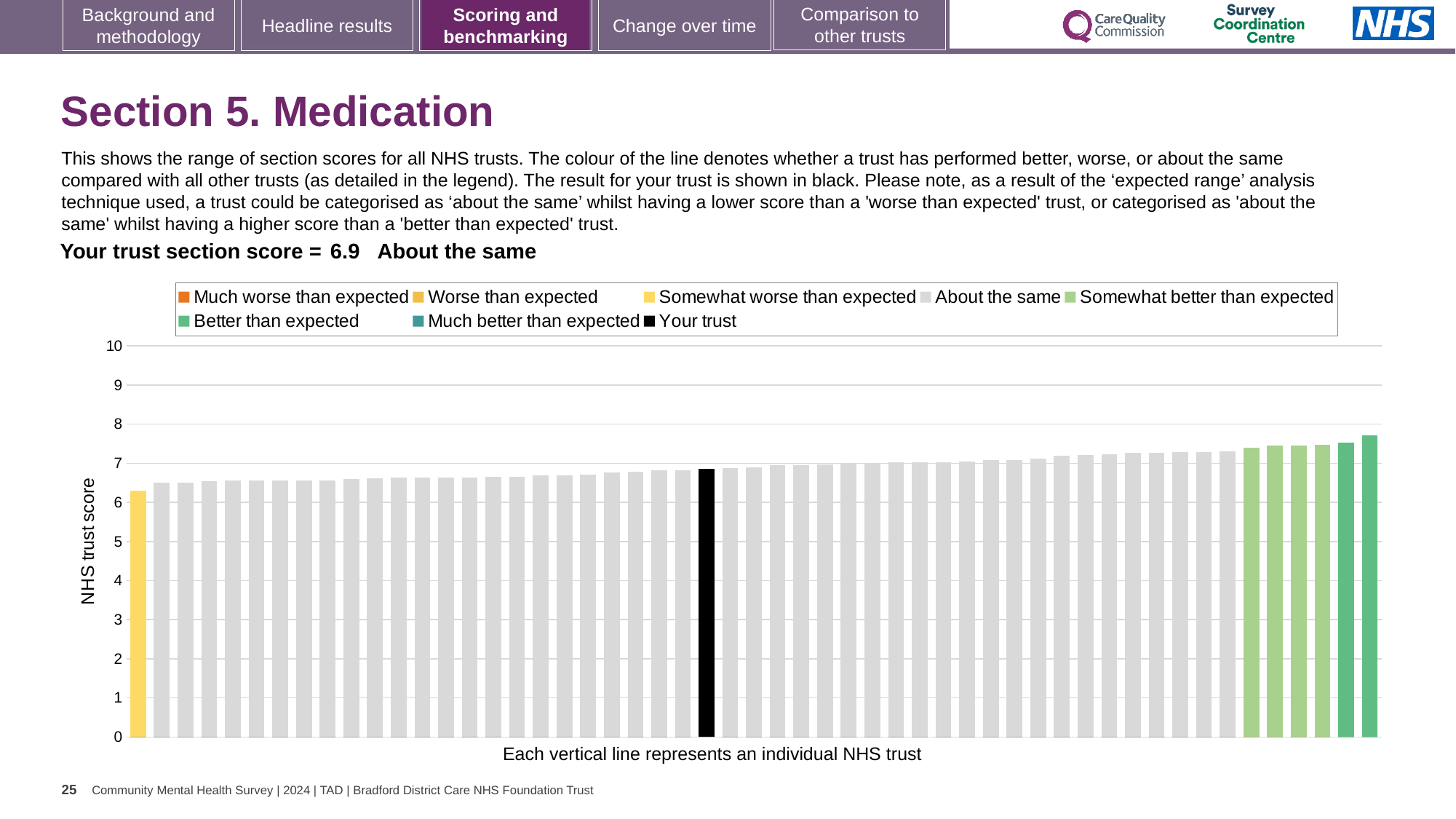
What is the section score for your trust shown on the slide? 6.9 Is the value of the highest bar in the chart greater or less than 8? less How many entries does the chart legend list? 8 Is the value of the lowest bar in the chart greater or less than 7? less Is the value of the lowest bar in the chart greater or less than 6? greater Do the bar values rise or fall from left to right along the x axis? rise What colour is used for the 'Your trust' bar in the chart? black What is the label on the vertical axis of the chart? NHS trust score What kind of chart is shown on the slide? bar chart Is the rightmost bar higher or lower than the leftmost bar? higher